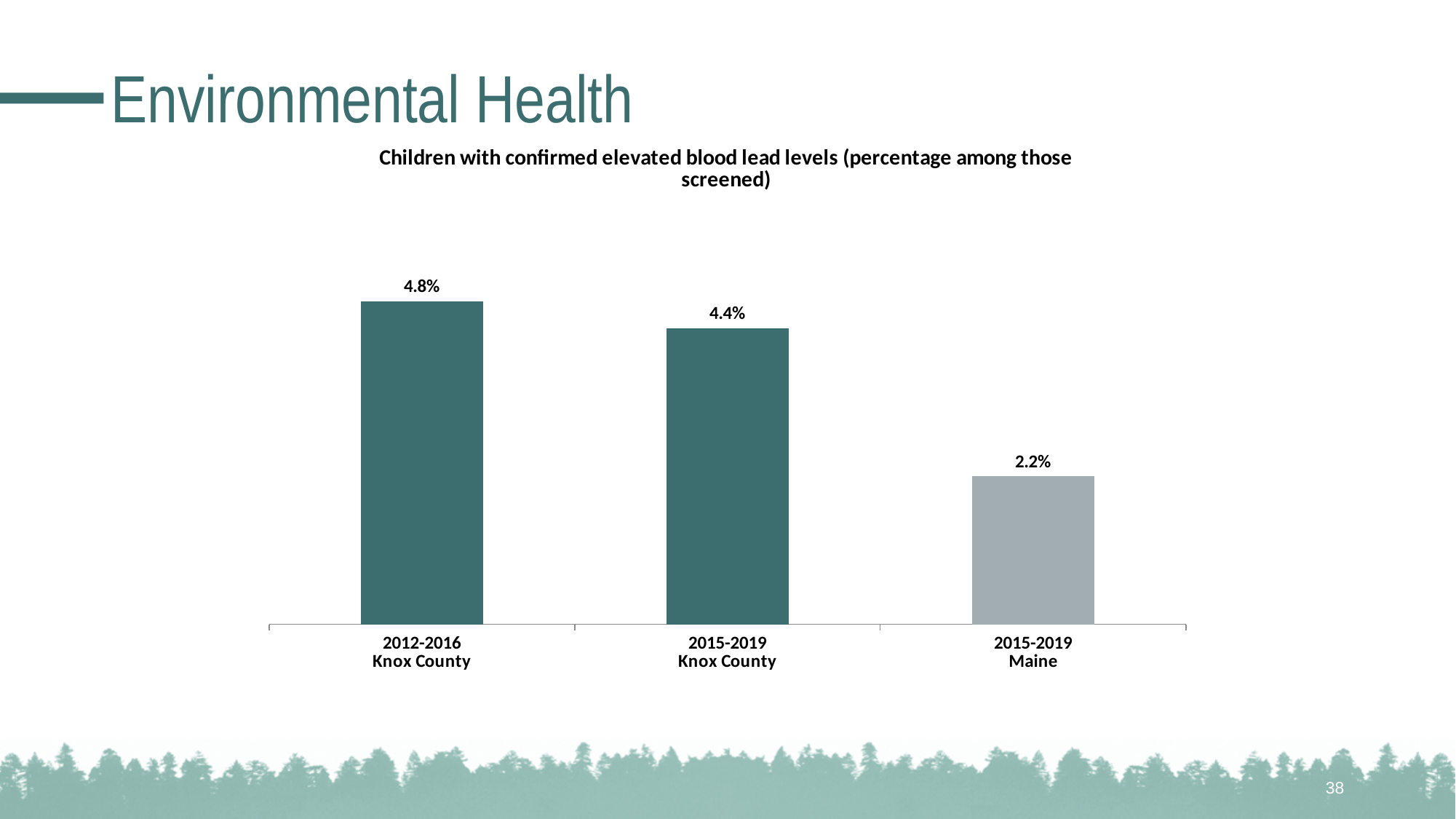
What is the difference between the 2015-2019 Knox County value and the 2015-2019 Maine value? 2.2% How many bars are shown in the chart? 3 What is the difference between the 2012-2016 Knox County value and the 2015-2019 Knox County value? 0.4% Which category has the lowest value? 2015-2019 Maine What is the value for 2015-2019 Knox County? 4.4% What is the value for 2012-2016 Knox County? 4.8% Which category has the highest value? 2012-2016 Knox County Which is larger, the value for 2015-2019 Knox County or the value for 2015-2019 Maine? 2015-2019 Knox County What is the title of the chart? Children with confirmed elevated blood lead levels (percentage among those screened) Do the values rise or fall from left to right across the chart? Fall What kind of chart is shown on the slide? Bar chart What is the value for 2015-2019 Maine? 2.2%